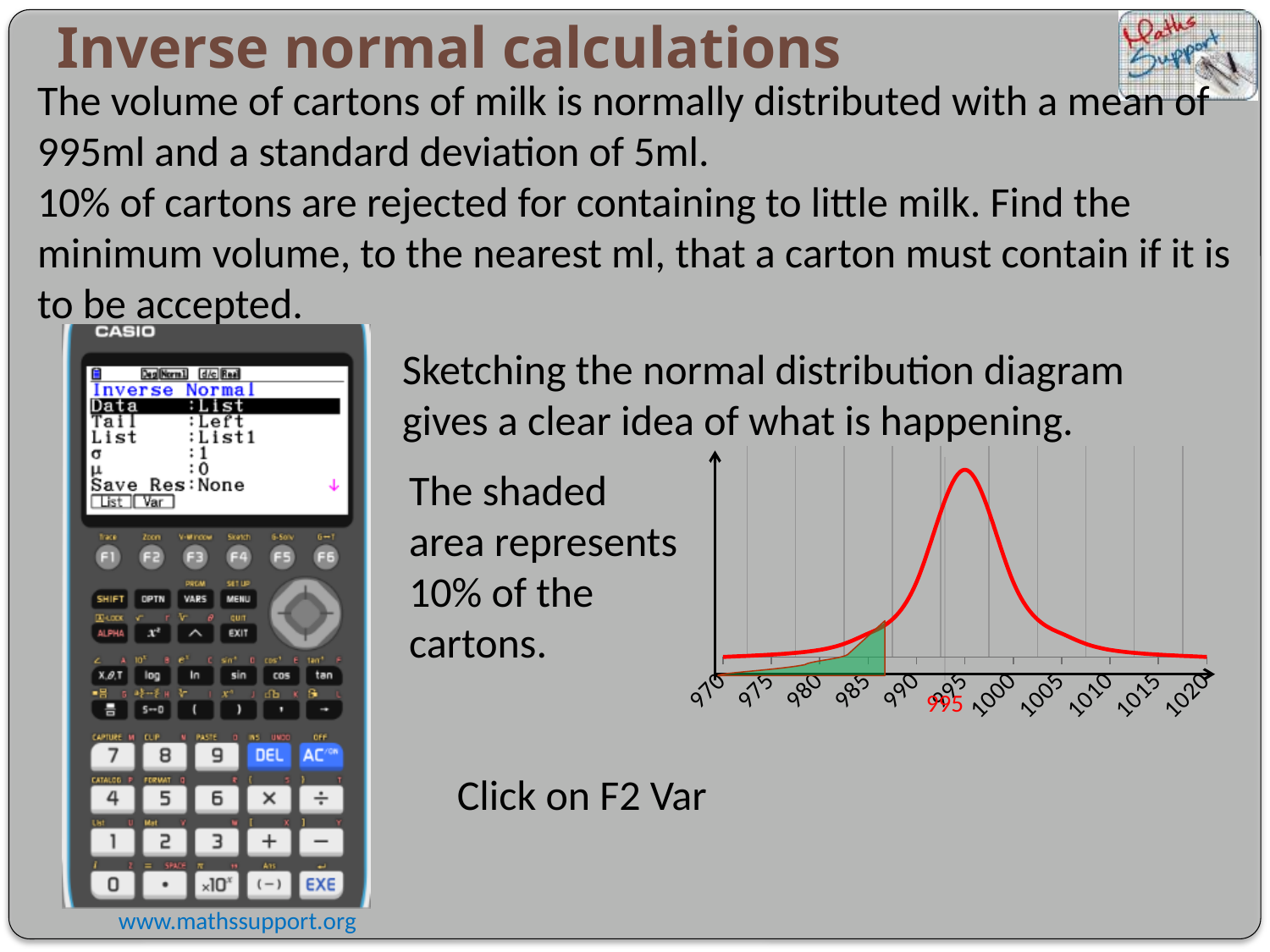
At which x-axis value does the curve in the normal distribution diagram reach its peak? 995 How many labelled tick values are shown on the x axis of the normal distribution diagram? 11 Which x-axis label in the normal distribution diagram is written in red? 995 Does the curve in the normal distribution diagram rise or fall as x increases from 970 to 995? Rise Is the shaded area in the normal distribution diagram in the left tail or the right tail of the curve? Left tail What colour is the shaded area under the curve in the normal distribution diagram? Green What is the step between consecutive labels on the x axis of the normal distribution diagram? 5 What percentage of the cartons does the shaded area in the normal distribution diagram represent? 10% What is the smallest value labelled on the x axis of the normal distribution diagram? 970 What kind of chart is shown on the right of the slide? A line chart (normal distribution curve) Does the curve in the normal distribution diagram rise or fall as x increases from 995 to 1020? Fall What is the largest value labelled on the x axis of the normal distribution diagram? 1020